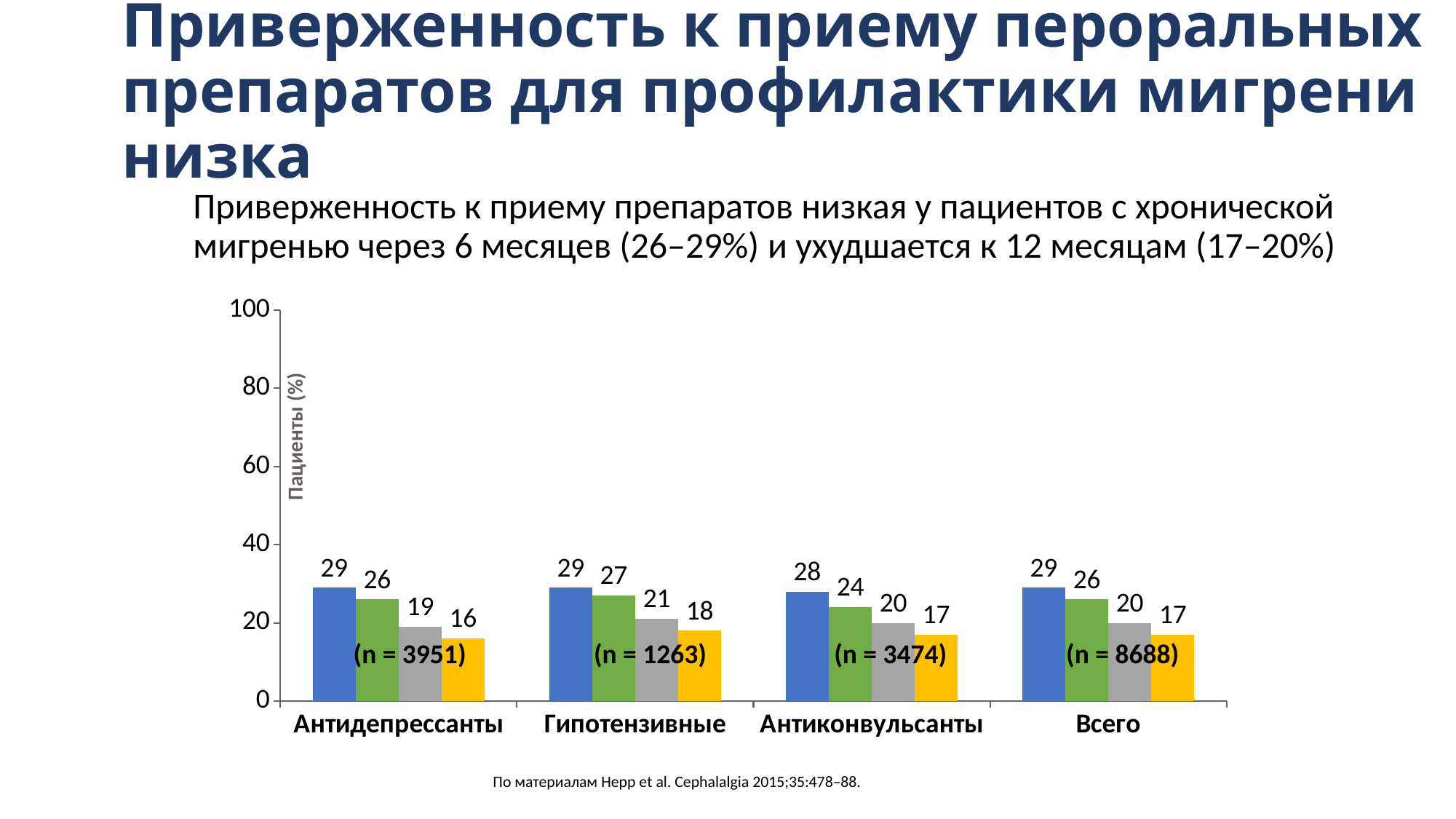
What type of chart is shown on the slide? bar chart What is the value of the yellow (last) bar for Антидепрессанты? 16 How many categories are shown on the x axis of the chart? 4 What is the value of the grey (third) bar for Антиконвульсанты? 20 What is the value of the blue (first) bar for Антидепрессанты? 29 Within each category, do the bar values rise or fall from the first bar to the last bar? fall What is the difference between the blue (first) bar and the yellow (last) bar for Гипотензивные? 11 What is the value of the green (second) bar for Гипотензивные? 27 What is the value of the yellow (last) bar for Всего? 17 How many bars are plotted for each category in the chart? 4 Which is larger for Антиконвульсанты: the green (second) bar or the grey (third) bar? the green (second) bar What sample size (n) is shown for the Всего category? n = 8688